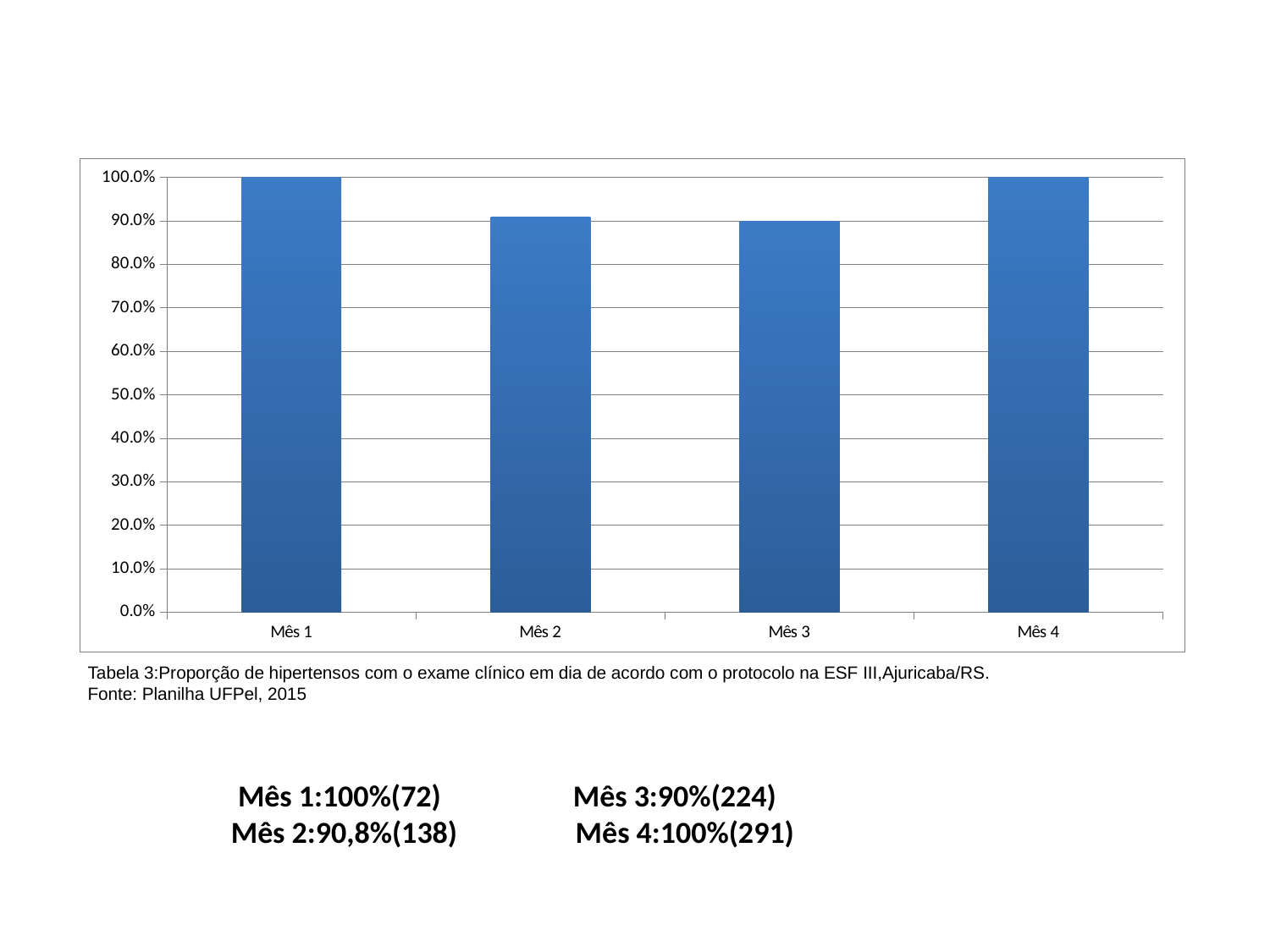
What source is cited below the chart? Planilha UFPel, 2015 How many hypertensive patients does the text below the chart give for Mês 4? 291 What is the value for Mês 4? 100% What kind of chart is shown on the slide? bar chart What is the value for Mês 2? 90,8% Is the value for Mês 3 greater or less than 80%? greater What is the value for Mês 3? 90% Which is larger, the value for Mês 1 or the value for Mês 2? Mês 1 Does the value rise or fall from Mês 3 to Mês 4? rise What is the value for Mês 1? 100% How many categories (months) are shown on the x axis? 4 What is the difference between the values for Mês 1 and Mês 3? 10%